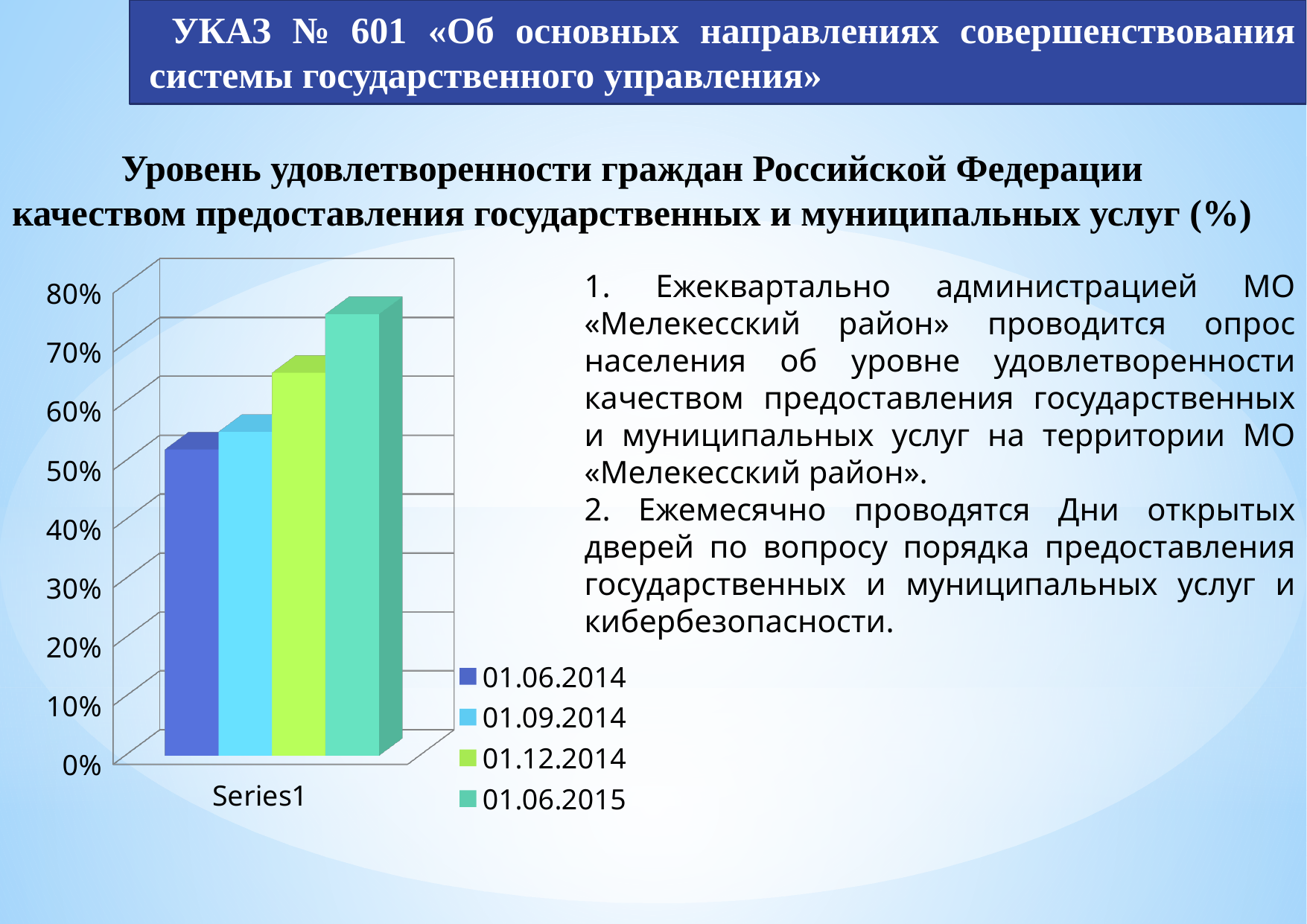
Which is larger, the value for 01.12.2014 or the value for 01.09.2014? 01.12.2014 Is the value for 01.06.2015 greater or less than 70%? greater What is the category label shown on the x axis of the chart? Series1 How many series does the chart legend list? 4 Is the value for 01.12.2014 greater or less than 60%? greater Which series has the highest value in the chart? 01.06.2015 Is the value for 01.06.2014 greater or less than 60%? less Do the values rise or fall from 01.06.2014 to 01.06.2015? rise Which series has the lowest value in the chart? 01.06.2014 What kind of chart is shown on the slide? bar chart